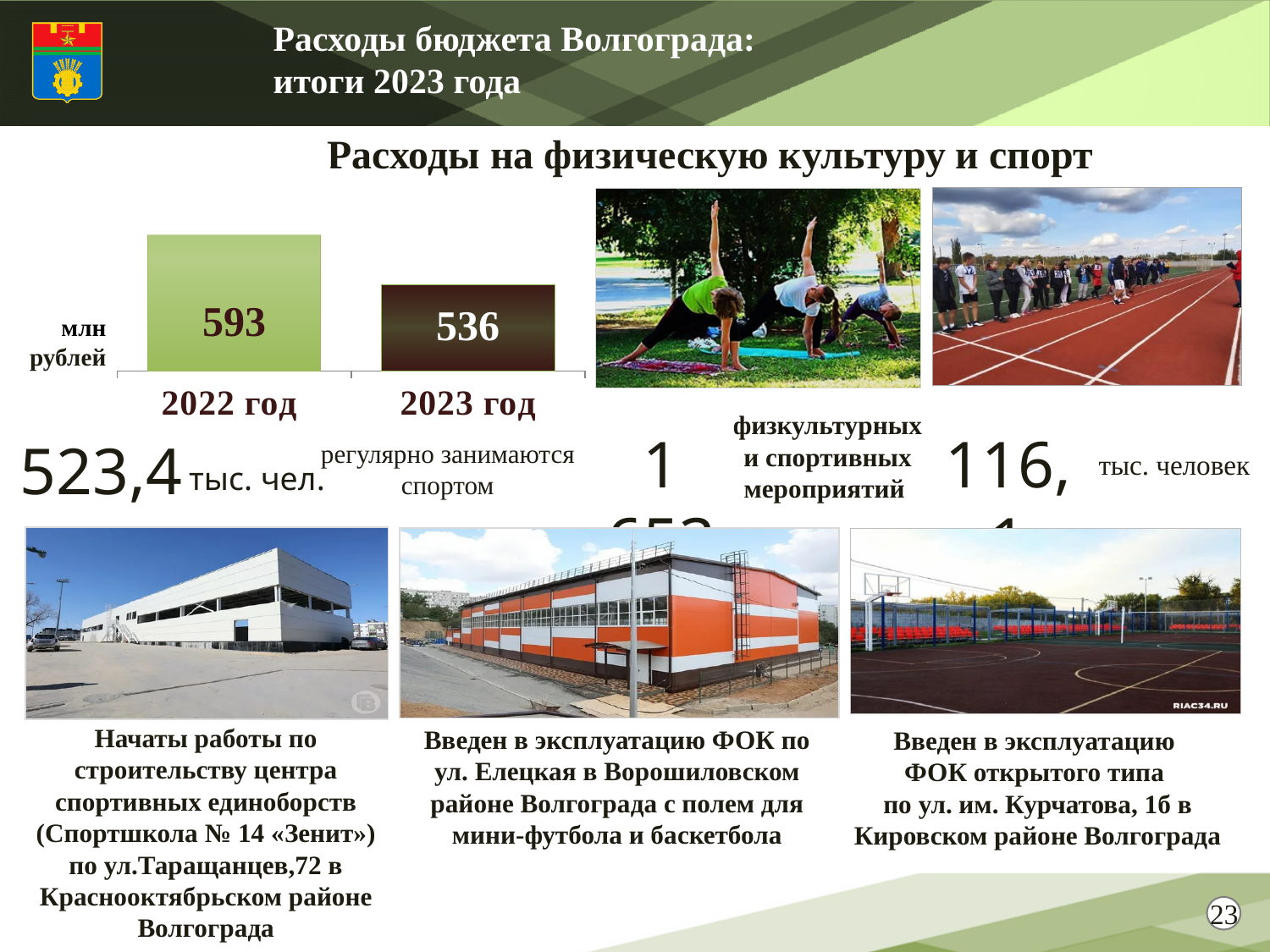
Which year has the lower value in the bar chart? 2023 год What is the title of the section containing the bar chart? Расходы на физическую культуру и спорт What is the value for 2023 год in the bar chart? 536 How many bars are shown in the bar chart? 2 Do the values in the bar chart rise or fall from 2022 год to 2023 год? fall Which year has the higher value in the bar chart? 2022 год What is the value for 2022 год in the bar chart? 593 Is the value for 2023 год larger or smaller than the value for 2022 год? smaller What unit is indicated for the values in the bar chart? млн рублей What is the difference between the 2022 год and 2023 год values in the bar chart? 57 What kind of chart is shown on the slide? bar chart